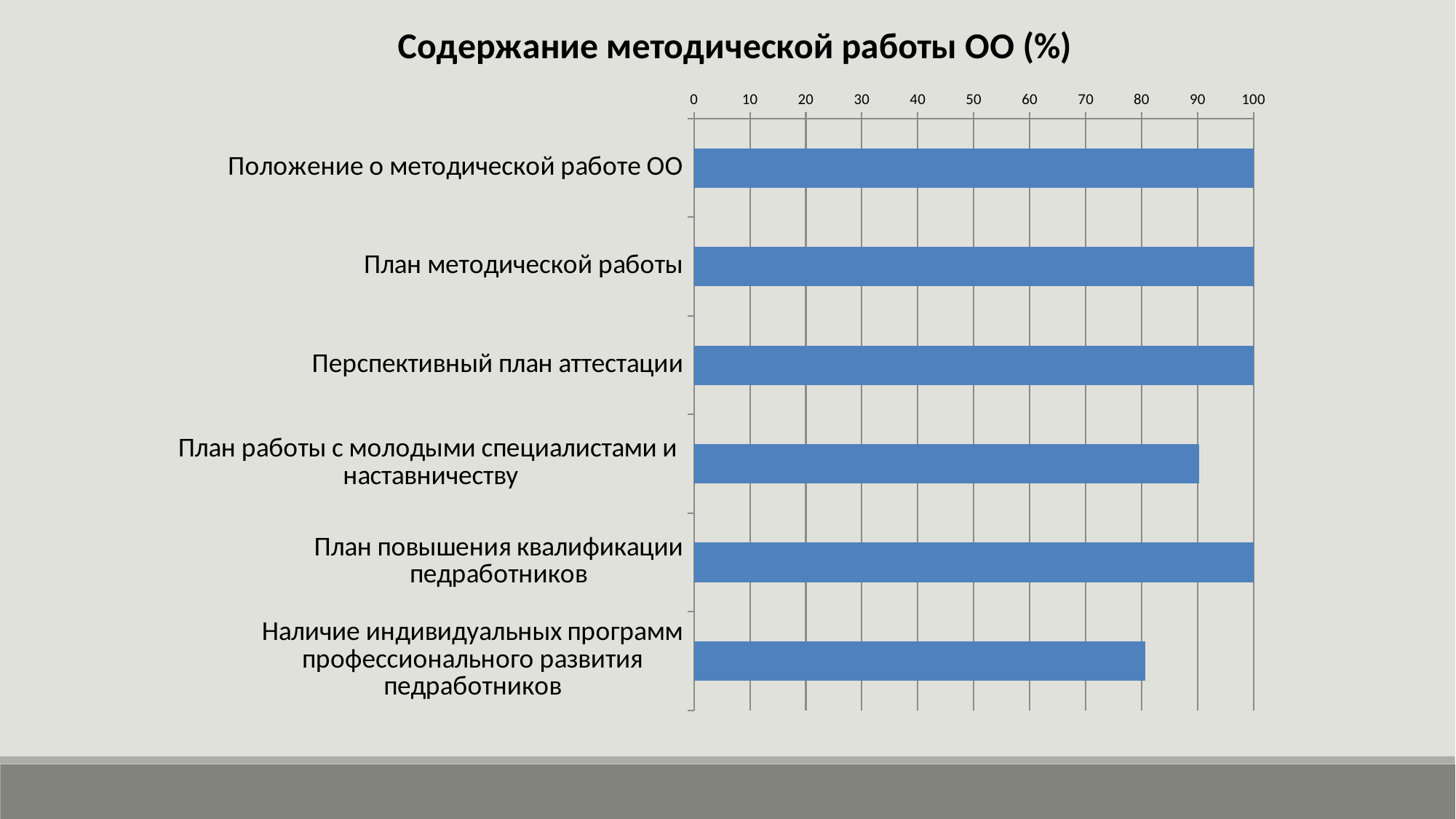
What is the value for "Положение о методической работе ОО"? 100 What is the title of the chart? Содержание методической работы ОО (%) How many categories are plotted in the chart? 6 What type of chart is shown on the slide? bar chart What is the value for "Перспективный план аттестации"? 100 Which category has the lowest value? Наличие индивидуальных программ профессионального развития педработников Which is larger: the value for "План методической работы" or the value for "План работы с молодыми специалистами и наставничеству"? План методической работы Is the value for "Наличие индивидуальных программ профессионального развития педработников" greater or less than 90? less What is the value for "План повышения квалификации педработников"? 100